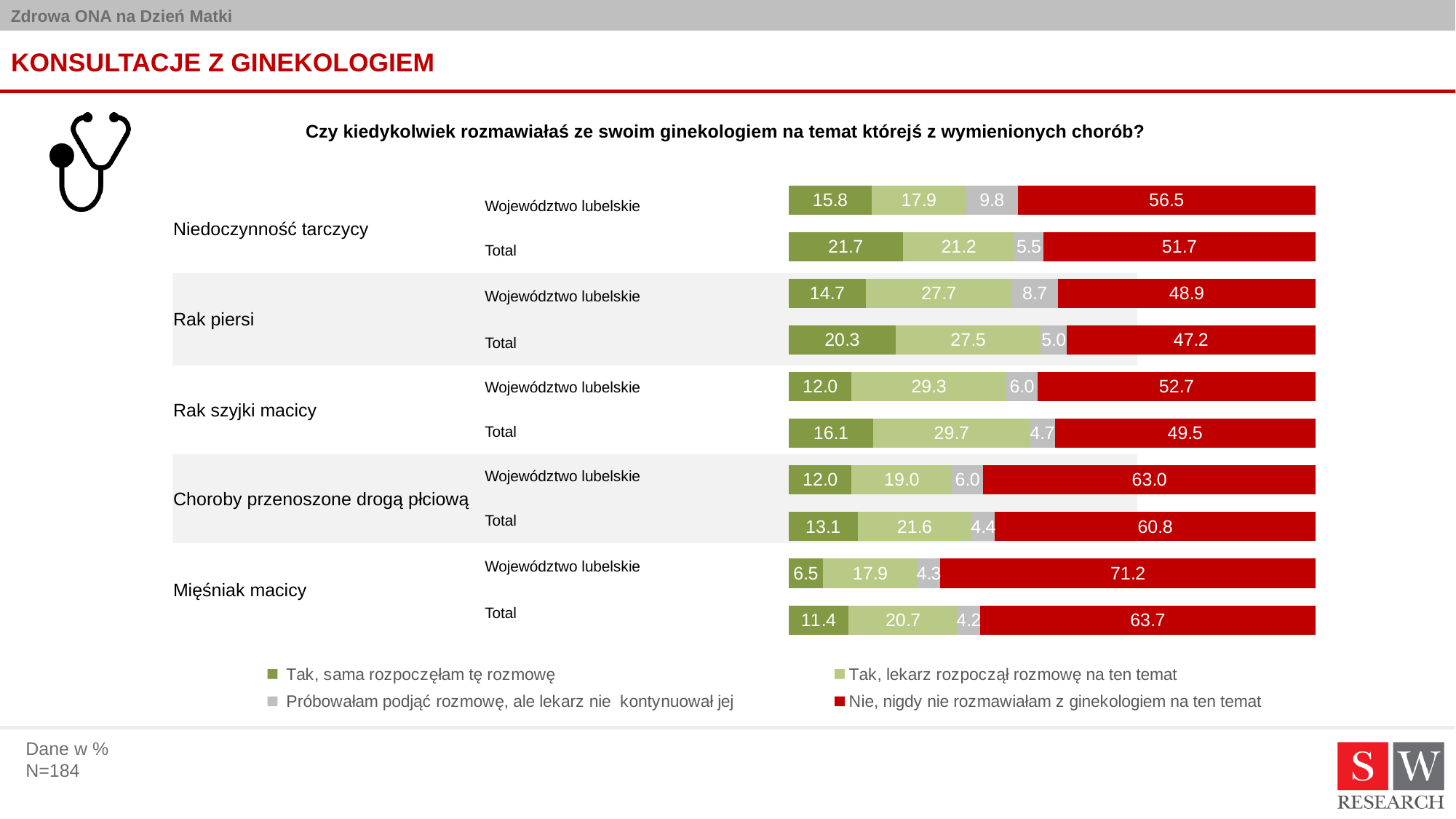
What is the value for "Próbowałam podjąć rozmowę, ale lekarz nie kontynuował jej" in the Województwo lubelskie bar for Rak piersi? 8.7 What kind of chart is shown on the slide? Stacked bar chart What is the value for "Nie, nigdy nie rozmawiałam z ginekologiem na ten temat" in the Województwo lubelskie bar for Mięśniak macicy? 71.2 What colour represents "Nie, nigdy nie rozmawiałam z ginekologiem na ten temat" in the chart? Red What is the difference between the "Tak, lekarz rozpoczął rozmowę na ten temat" values for Rak piersi in Województwo lubelskie and Total? 0.2 What is the total of the Total bar for Rak szyjki macicy? 100.0 Which is larger: the "Nie, nigdy nie rozmawiałam z ginekologiem na ten temat" value for Choroby przenoszone drogą płciową (Województwo lubelskie) or for Mięśniak macicy (Total)? Mięśniak macicy (Total) Which bar has the highest value for "Nie, nigdy nie rozmawiałam z ginekologiem na ten temat"? Mięśniak macicy, Województwo lubelskie What is the value for "Tak, sama rozpoczęłam tę rozmowę" in the Total bar for Niedoczynność tarczycy? 21.7 Which bar has the lowest value for "Tak, sama rozpoczęłam tę rozmowę"? Mięśniak macicy, Województwo lubelskie How many series does the legend list? 4 How many bars are plotted in the chart? 10